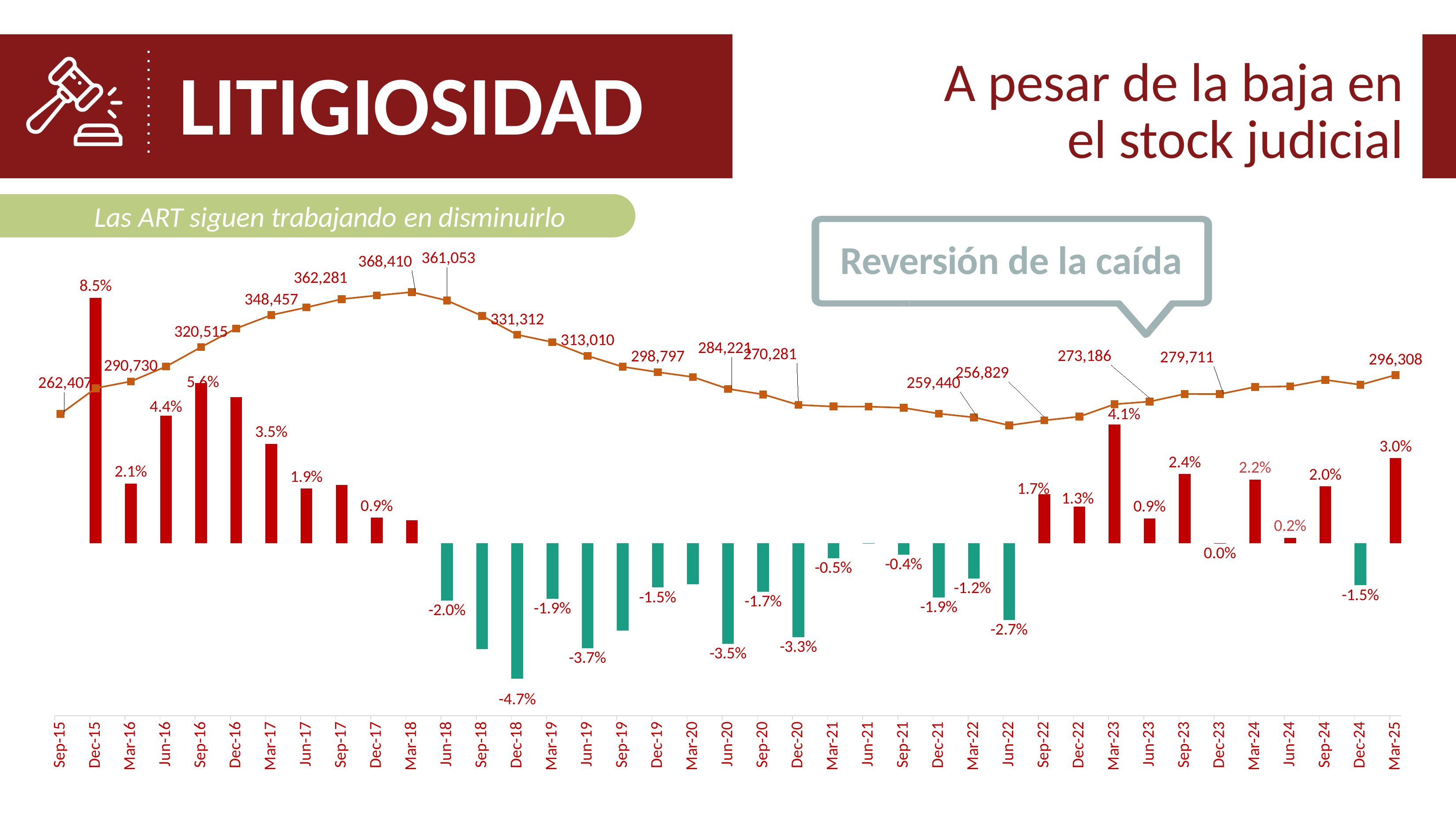
What is the bar value for Mar-23? 4.1% What is the lowest value labelled on the line? 256,829 What is the difference between the bar values for Dec-15 and Mar-23? 4.4 percentage points What text appears in the callout box above the line chart? Reversión de la caída Which quarter has the lowest bar value? Dec-18 What is the bar value for Mar-25? 3.0% What is the bar value for Dec-18? -4.7% What is the highest value labelled on the line? 368,410 What kind of chart is shown on the slide? A combined bar and line chart Which bar is larger, Jun-16 or Sep-16? Sep-16 Which quarter has the highest bar value? Dec-15 What is the bar value for Dec-15? 8.5%